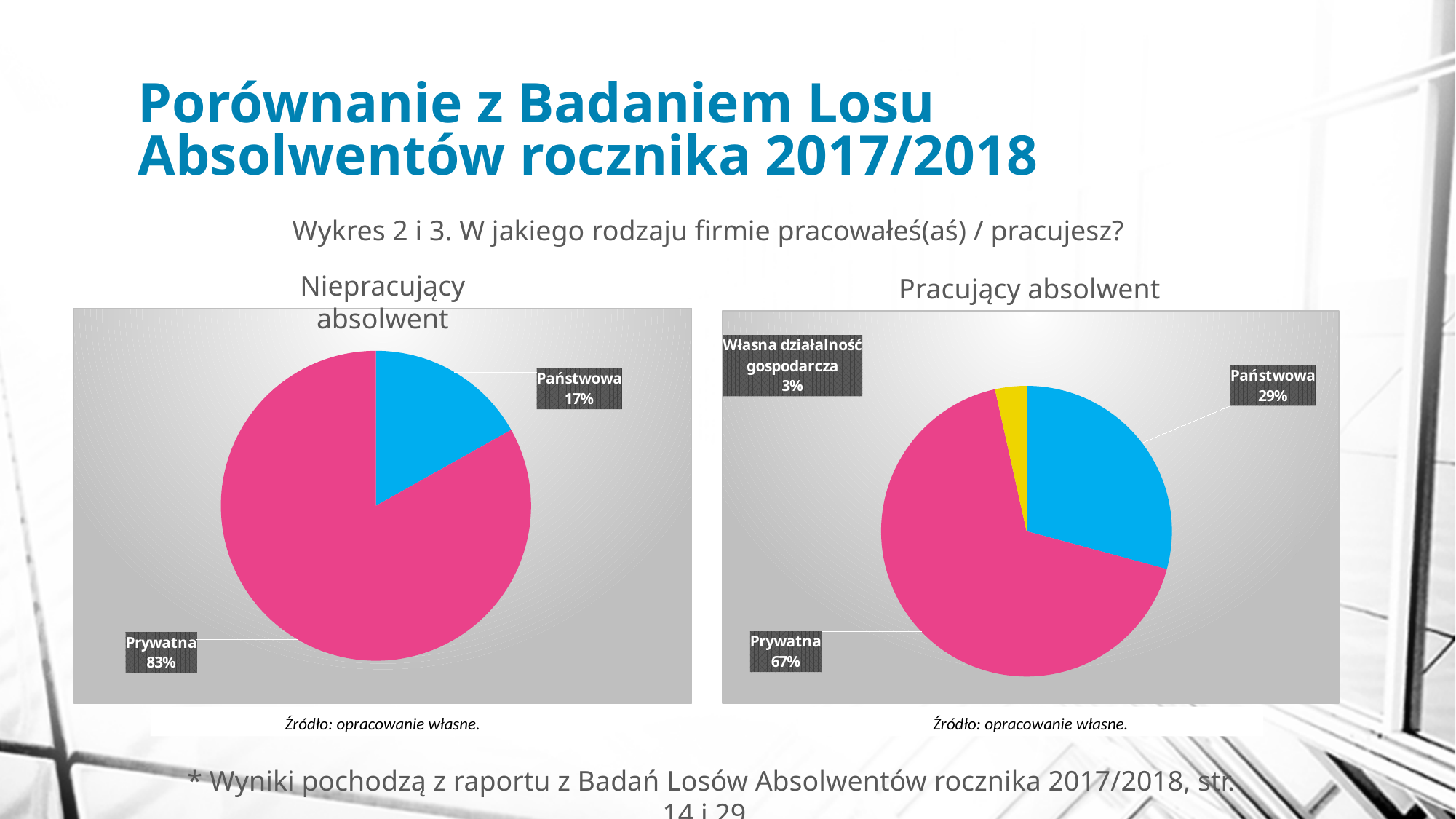
In the 'Pracujący absolwent' pie chart, what colour is the Własna działalność gospodarcza slice? Yellow How many slices does the 'Pracujący absolwent' pie chart have? 3 In the 'Pracujący absolwent' pie chart, which category has the largest slice? Prywatna In the 'Pracujący absolwent' pie chart, what share is labelled for Państwowa? 29% How many slices does the 'Niepracujący absolwent' pie chart have? 2 Which chart shows a larger share for Państwowa, 'Niepracujący absolwent' or 'Pracujący absolwent'? Pracujący absolwent What type of chart is used for 'Pracujący absolwent'? Pie chart In the 'Niepracujący absolwent' pie chart, what share is labelled for Prywatna? 83% In the 'Niepracujący absolwent' pie chart, what is the difference between the Prywatna and Państwowa shares? 66% In the 'Pracujący absolwent' pie chart, what share is labelled for Własna działalność gospodarcza? 3% In the 'Niepracujący absolwent' pie chart, what share is labelled for Państwowa? 17% In the 'Pracujący absolwent' pie chart, which category has the smallest slice? Własna działalność gospodarcza